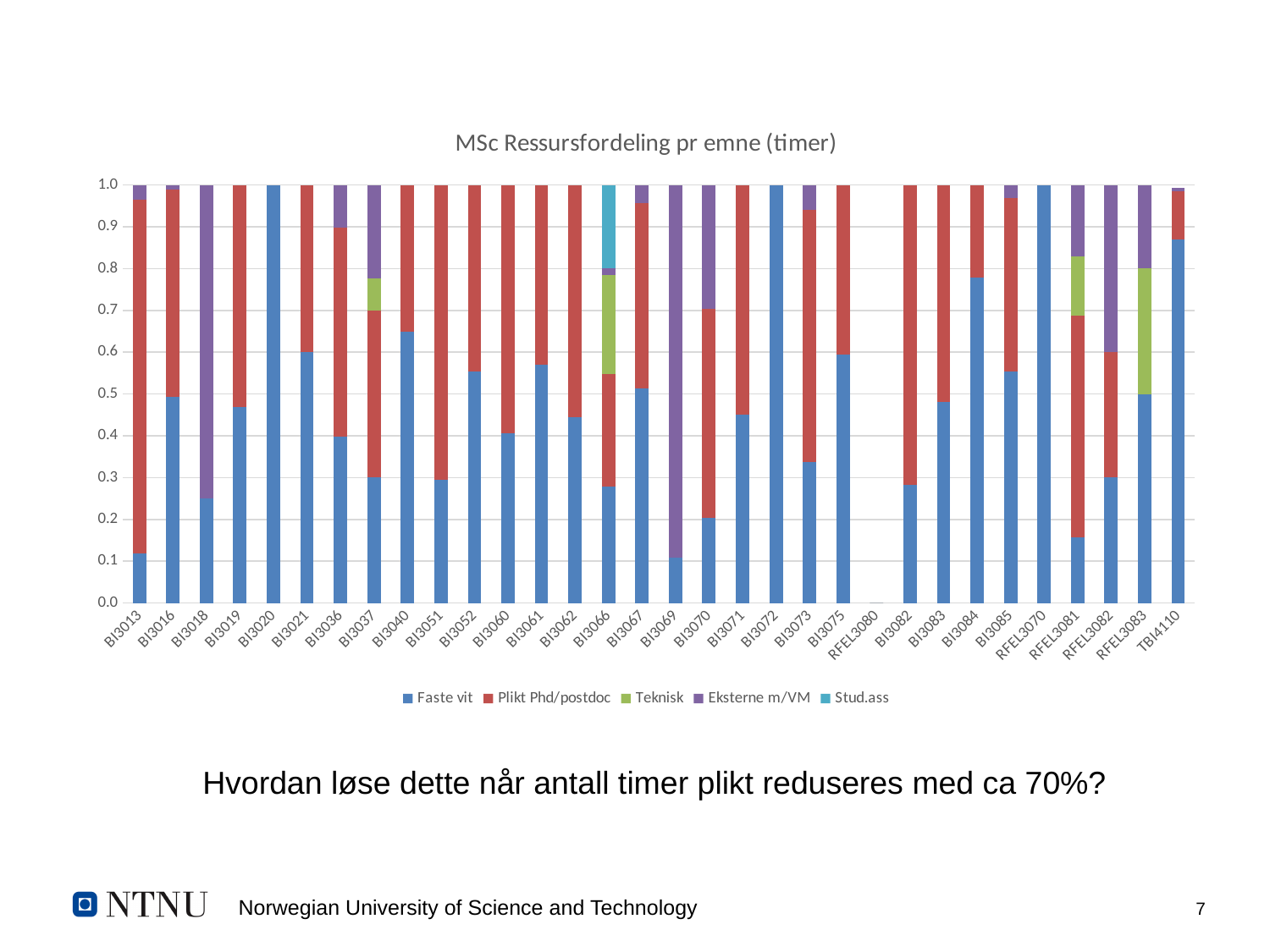
How many course categories are shown on the x axis? 32 How many series does the legend list? 5 What kind of chart is shown on the slide? Bar chart Is the Faste vit value for BI3069 greater or less than 0.2? less Is the Faste vit value for BI3020 greater or less than 0.9? greater Is the Faste vit value for BI3072 greater or less than 0.9? greater Which category is the only one with a Stud.ass segment? BI3066 What is the title of the chart? MSc Ressursfordeling pr emne (timer)